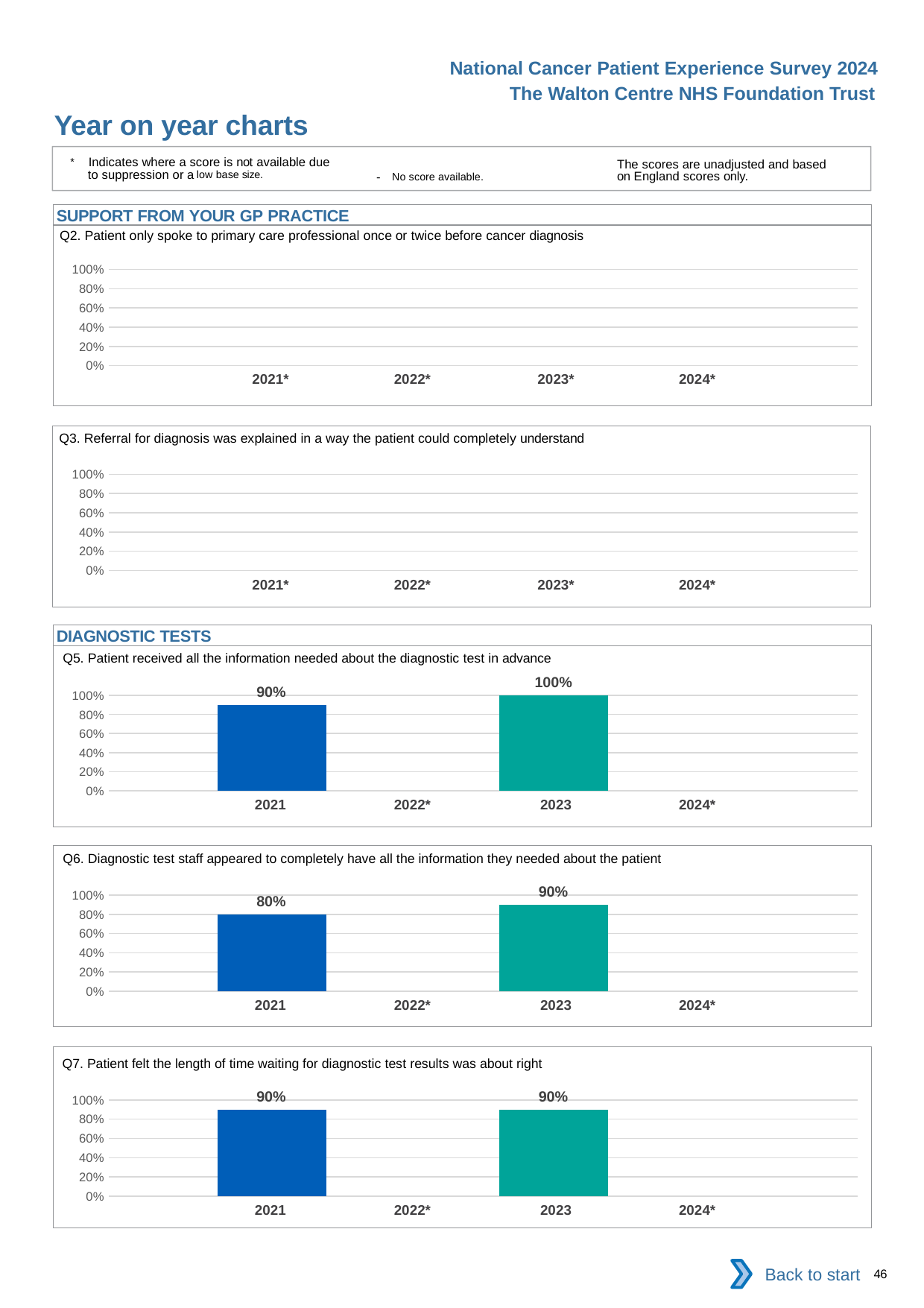
In the Q5 chart (Patient received all the information needed about the diagnostic test in advance), what is the value for 2021? 90% In the Q6 chart (Diagnostic test staff appeared to completely have all the information they needed about the patient), which is larger, the 2021 value or the 2023 value? 2023 In the Q5 chart (Patient received all the information needed about the diagnostic test in advance), which year has the highest value? 2023 In the Q5 chart (Patient received all the information needed about the diagnostic test in advance), what is the value for 2023? 100% In the Q5 chart (Patient received all the information needed about the diagnostic test in advance), what is the difference between the 2023 and 2021 values? 10% In the Q6 chart (Diagnostic test staff appeared to completely have all the information they needed about the patient), what is the value for 2021? 80% In the Q7 chart (Patient felt the length of time waiting for diagnostic test results was about right), what is the value for 2021? 90% In the Q6 chart (Diagnostic test staff appeared to completely have all the information they needed about the patient), what is the value for 2023? 90% In the Q6 chart (Diagnostic test staff appeared to completely have all the information they needed about the patient), what is the difference between the 2023 and 2021 values? 10% In the Q7 chart (Patient felt the length of time waiting for diagnostic test results was about right), what is the value for 2023? 90% In the Q7 chart (Patient felt the length of time waiting for diagnostic test results was about right), how many years have a bar plotted? 2 What kind of chart is the Q6 chart (Diagnostic test staff appeared to completely have all the information they needed about the patient)? Bar chart